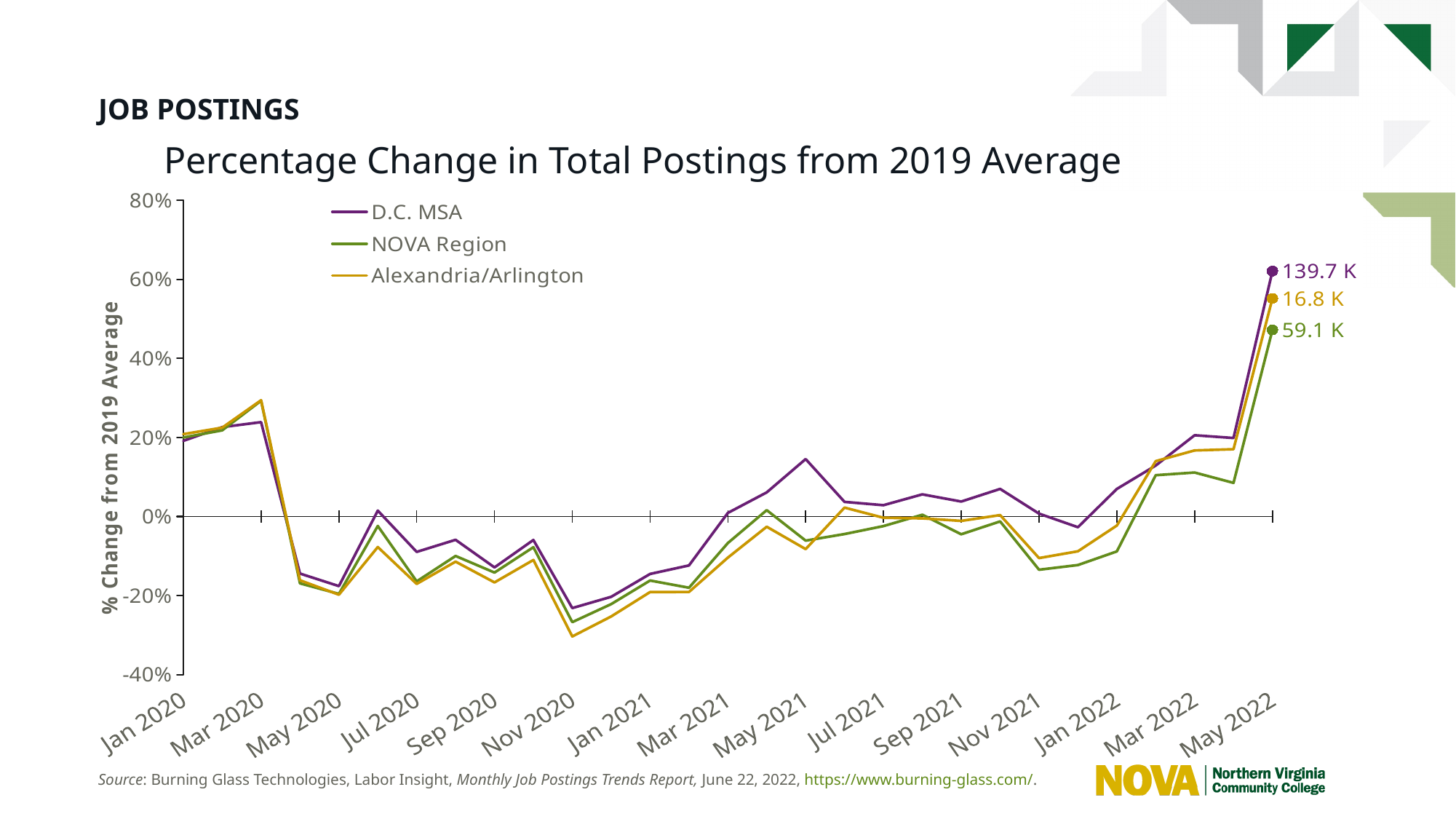
What value label is printed at the end of the D.C. MSA line in May 2022? 139.7 K Do the values for all three series rise or fall between Jan 2022 and May 2022? rise Is the value for Alexandria/Arlington in Nov 2020 greater or less than -20%? less What type of chart is shown on the slide? Line chart What is the title of the chart? Percentage Change in Total Postings from 2019 Average Is the value for NOVA Region in May 2022 greater or less than 40%? greater What value label is printed at the end of the Alexandria/Arlington line in May 2022? 16.8 K What value label is printed at the end of the NOVA Region line in May 2022? 59.1 K What is the label on the vertical axis of the chart? % Change from 2019 Average How many series does the legend list? 3 Which series has the highest percentage change in May 2022? D.C. MSA Which series has the lowest percentage change in Nov 2020? Alexandria/Arlington